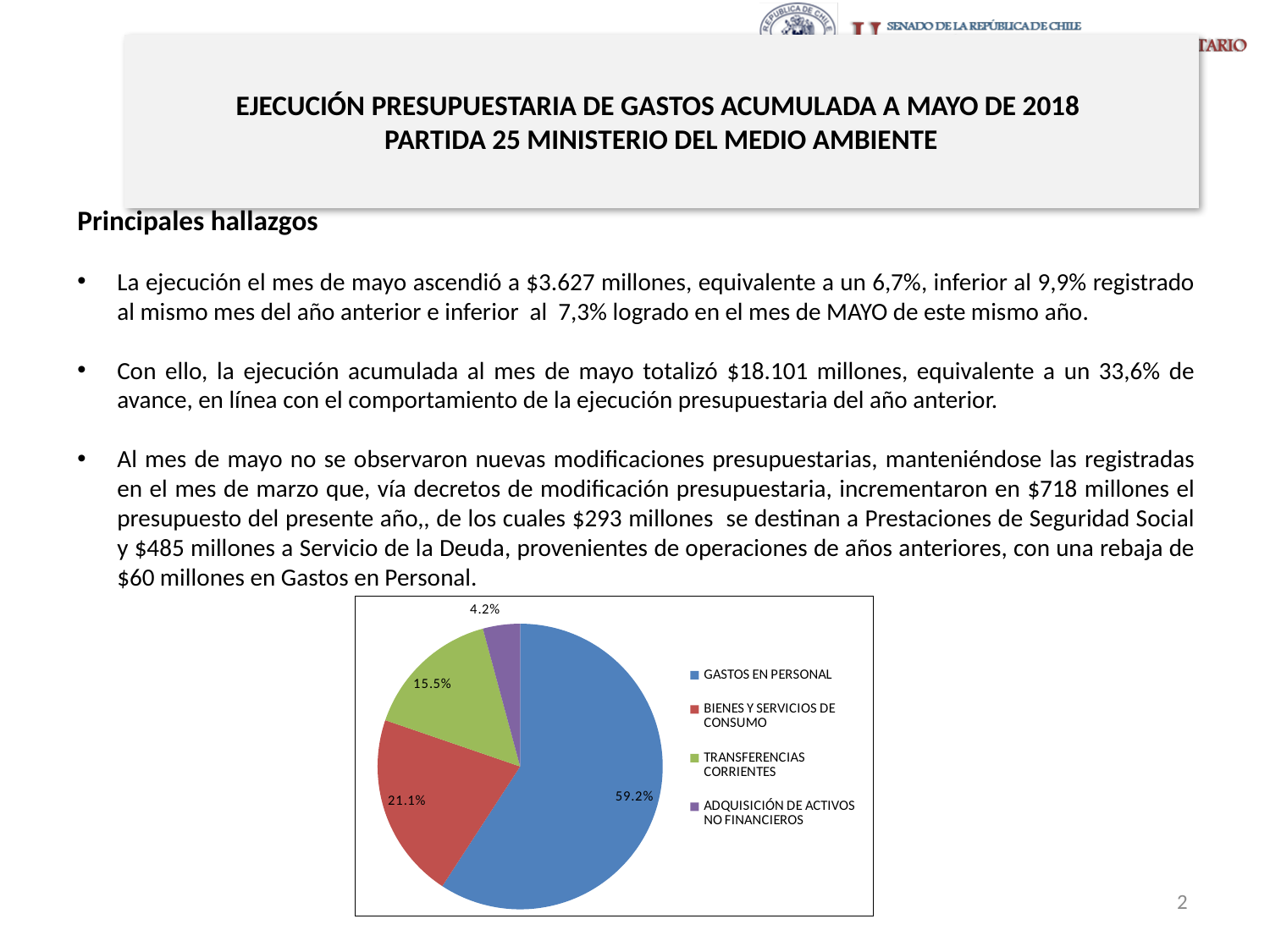
Which category has the smallest slice of the pie? ADQUISICIÓN DE ACTIVOS NO FINANCIEROS How many categories does the pie chart show? 4 What share of the pie does BIENES Y SERVICIOS DE CONSUMO represent? 21.1% Which category has the largest slice of the pie? GASTOS EN PERSONAL What share of the pie does TRANSFERENCIAS CORRIENTES represent? 15.5% What kind of chart is shown on the slide? pie chart Which is larger, the slice for BIENES Y SERVICIOS DE CONSUMO or the slice for TRANSFERENCIAS CORRIENTES? BIENES Y SERVICIOS DE CONSUMO What is the difference in percentage points between the GASTOS EN PERSONAL slice and the BIENES Y SERVICIOS DE CONSUMO slice? 38.1 percentage points What colour is the slice for TRANSFERENCIAS CORRIENTES in the pie chart? green What share of the pie does GASTOS EN PERSONAL represent? 59.2% What is the difference in percentage points between the TRANSFERENCIAS CORRIENTES slice and the ADQUISICIÓN DE ACTIVOS NO FINANCIEROS slice? 11.3 percentage points